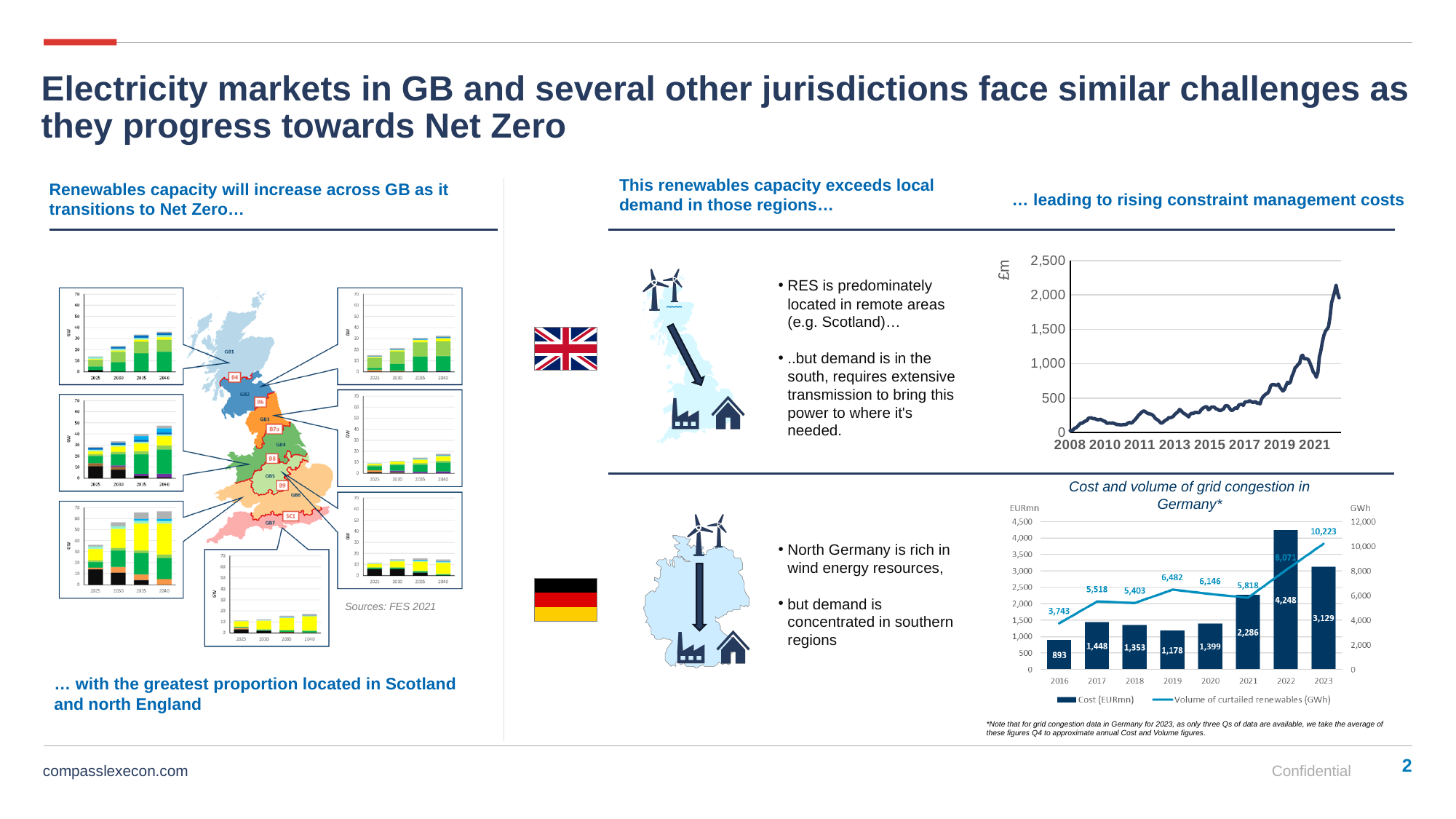
In the 'Cost and volume of grid congestion in Germany*' chart, which year had the highest cost in EURmn? 2022 How many years are shown on the x axis of the 'Cost and volume of grid congestion in Germany*' chart? 8 In the constraint management costs line chart (£m) on the right, is the value for 2008 greater or less than 500? less In the 'Cost and volume of grid congestion in Germany*' chart, which year had the lowest volume of curtailed renewables? 2016 What type of chart is the constraint management costs chart (£m, 2008–2021) on the right of the slide? Line chart How many series does the legend of the 'Cost and volume of grid congestion in Germany*' chart list? 2 In the constraint management costs line chart (£m) on the right, is the value for 2021 greater or less than 1,500? less In the 'Cost and volume of grid congestion in Germany*' chart, what was the cost in EURmn in 2016? 893 In the 'Cost and volume of grid congestion in Germany*' chart, what was the cost in EURmn in 2022? 4,248 In the 'Cost and volume of grid congestion in Germany*' chart, what is the difference in cost (EURmn) between 2022 and 2023? 1,119 In the 'Cost and volume of grid congestion in Germany*' chart, what was the volume of curtailed renewables in GWh in 2023? 10,223 In the 'Cost and volume of grid congestion in Germany*' chart, which year had the higher cost, 2018 or 2020? 2020